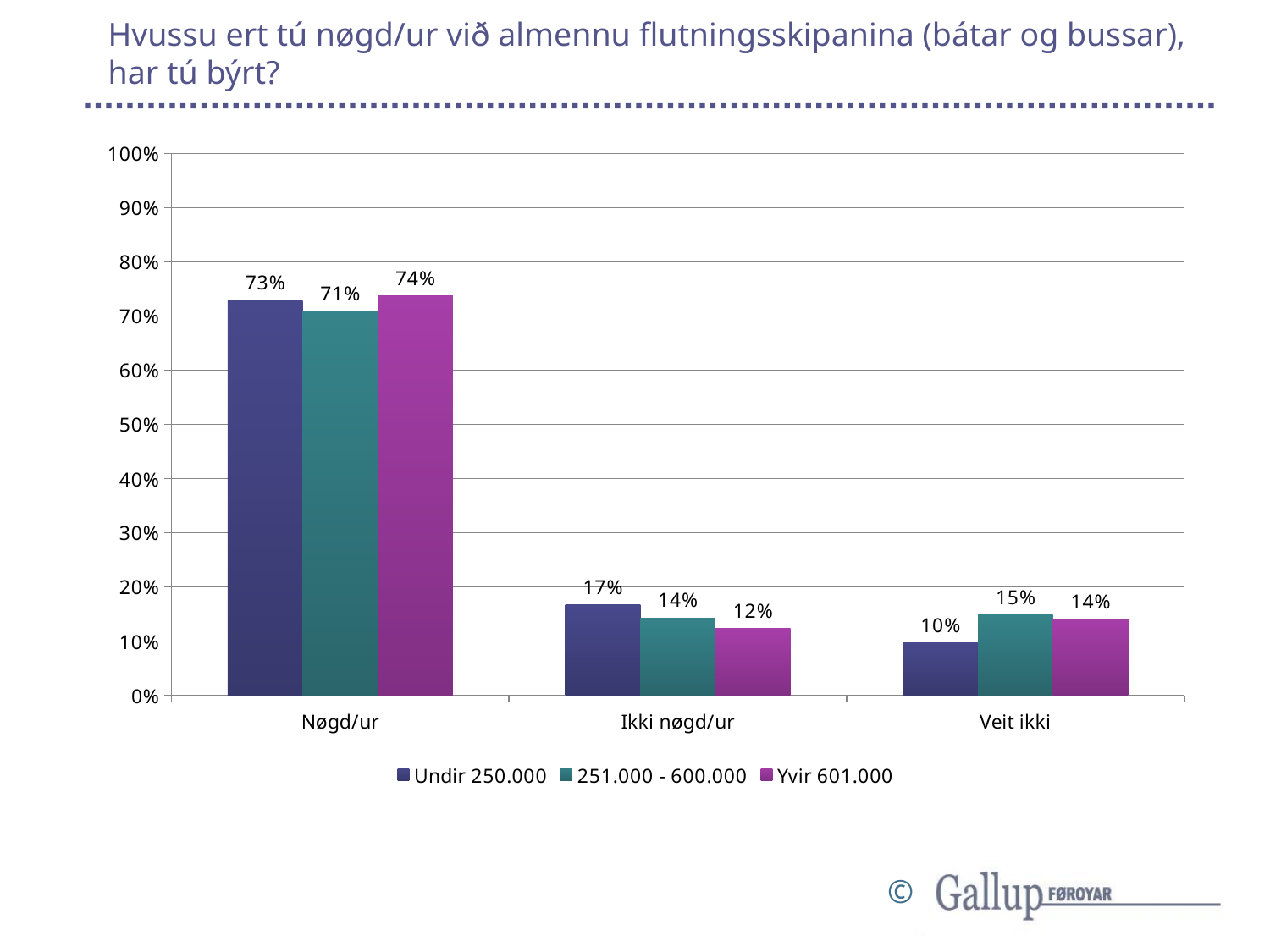
What is the difference between the Undir 250.000 and Yvir 601.000 values in the Ikki nøgd/ur category? 5% Which series has the lowest value in the Veit ikki category? Undir 250.000 How many categories are shown on the x axis? 3 How many series does the legend list? 3 What kind of chart is shown on the slide? bar chart Is the value for 251.000 - 600.000 in the Nøgd/ur category greater or less than 60%? greater What is the value for 251.000 - 600.000 in the Ikki nøgd/ur category? 14% Which series has the highest value in the Nøgd/ur category? Yvir 601.000 What is the value for Undir 250.000 in the Nøgd/ur category? 73% Which series is shown in purple/magenta in the legend? Yvir 601.000 Which is larger in the Nøgd/ur category: Undir 250.000 or 251.000 - 600.000? Undir 250.000 What is the value for Yvir 601.000 in the Veit ikki category? 14%